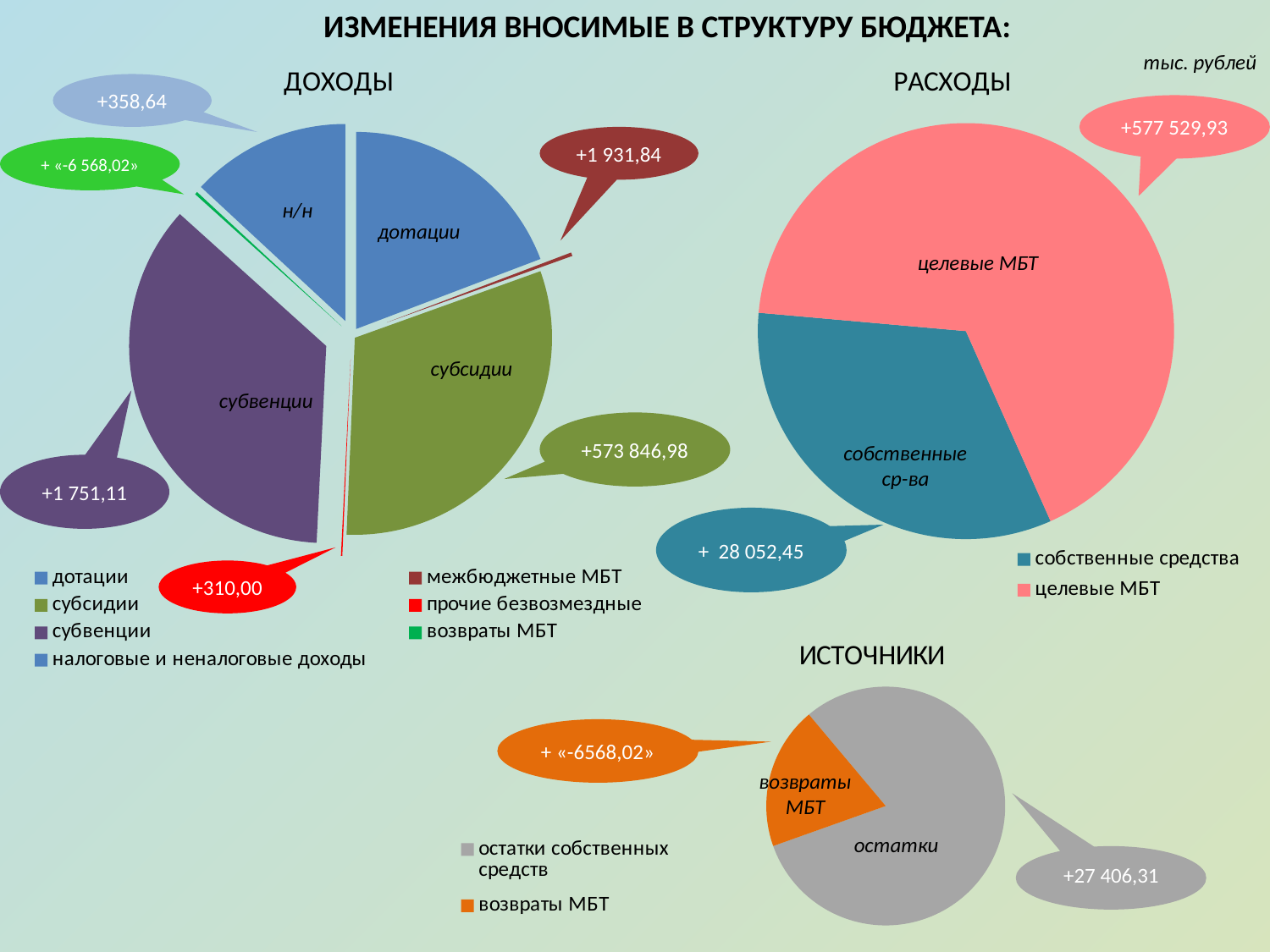
What kind of chart is the ДОХОДЫ chart? pie chart In the ДОХОДЫ chart, what change value is shown in the callout for субвенции? +1 751,11 In the ИСТОЧНИКИ chart, which slice is the largest? остатки собственных средств In the РАСХОДЫ chart, what change value is shown in the callout for собственные ср-ва? + 28 052,45 In the РАСХОДЫ chart, which slice is the largest? целевые МБТ How many entries does the legend of the РАСХОДЫ chart list? 2 In the ДОХОДЫ chart, which slice is larger: субсидии or дотации? субсидии In the ИСТОЧНИКИ chart, what change value is shown in the callout for остатки? +27 406,31 In the ДОХОДЫ chart, what change value is shown in the callout for субсидии? +573 846,98 How many entries does the legend of the ДОХОДЫ chart list? 7 In the РАСХОДЫ chart, what change value is shown in the callout for целевые МБТ? +577 529,93 In what units are the values on the slide given, according to the note at the top right? тыс. рублей